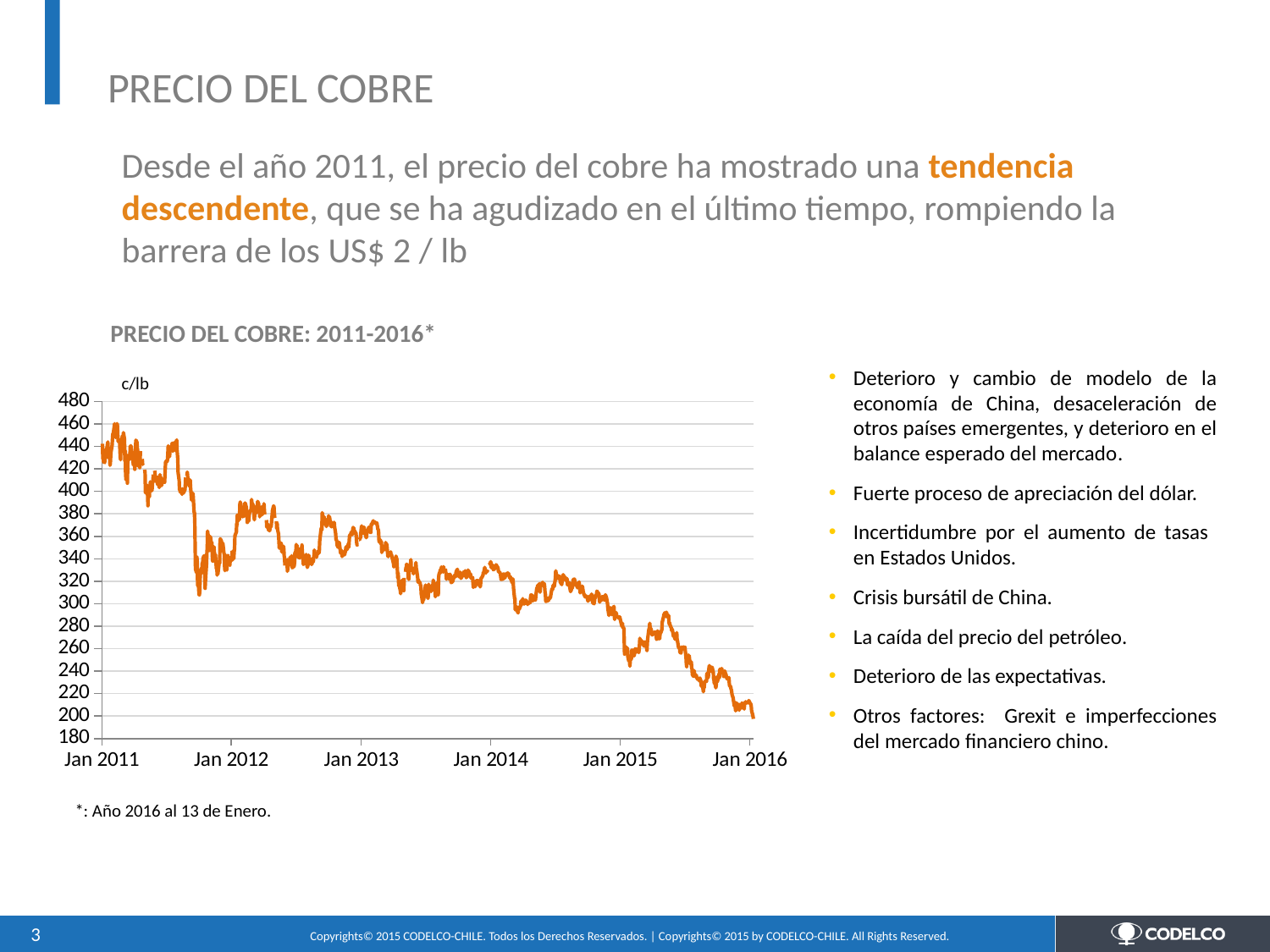
What unit is shown on the y axis of the chart? c/lb In which year labelled on the x axis does the copper price reach its highest level? Jan 2011 What is the title of the chart? PRECIO DEL COBRE: 2011-2016* How many year labels are shown on the x axis? 6 Is the copper price at Jan 2011 greater or less than 400? greater Is the copper price at Jan 2015 greater or less than 300? less Which is higher, the copper price at Jan 2011 or at Jan 2016? Jan 2011 Is the copper price at Jan 2016 greater or less than 220? less Does the copper price generally rise or fall from Jan 2011 to Jan 2016? fall What kind of chart is shown on the slide? line chart